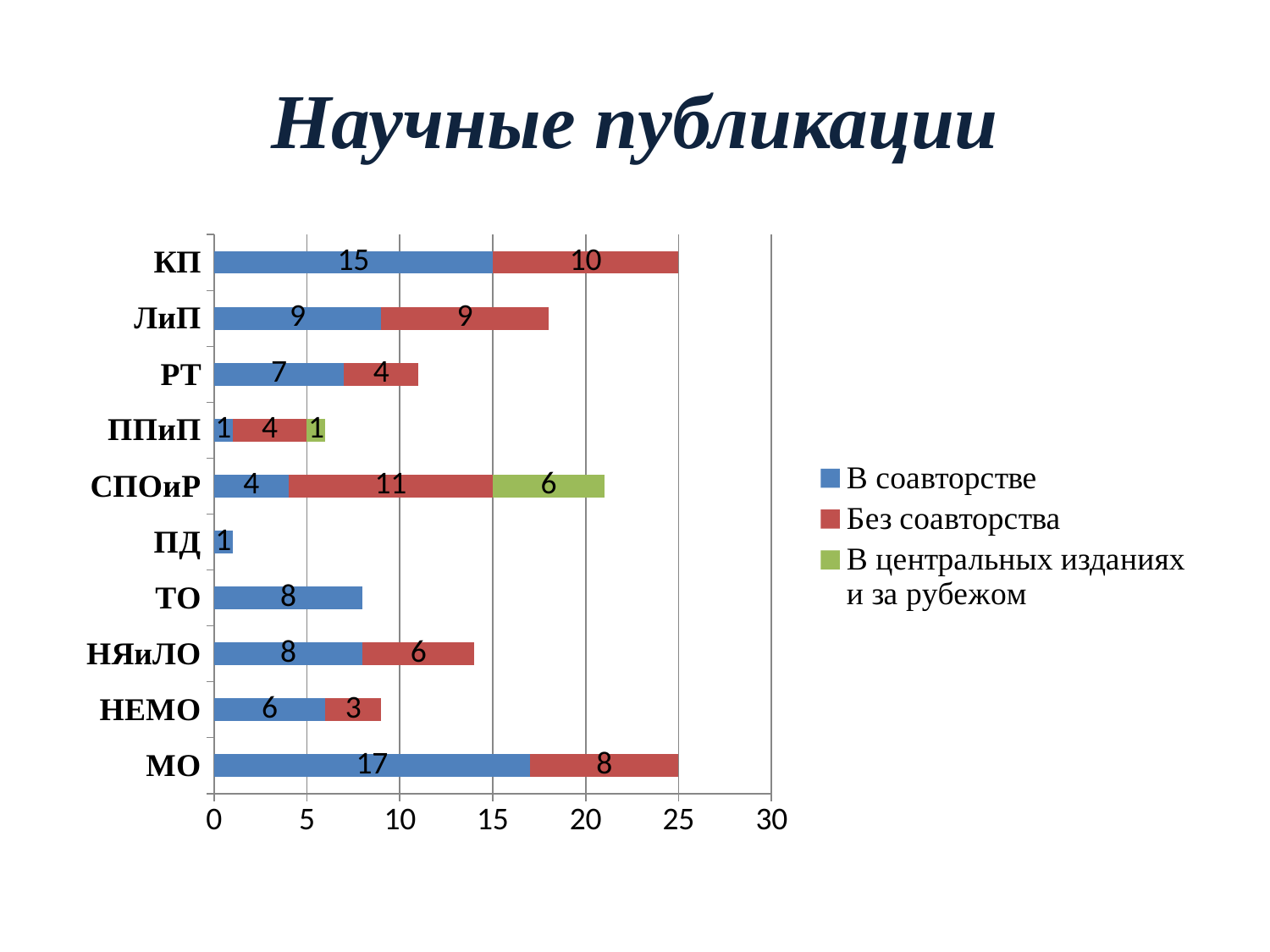
How many series does the legend list? 3 Which is larger: the 'Без соавторства' value for НЯиЛО or for НЕМО? НЯиЛО What kind of chart is shown on the slide? stacked bar chart How many categories are shown on the vertical axis? 10 What is the difference between the 'В соавторстве' values for КП and ЛиП? 6 What is the value of 'Без соавторства' for СПОиР? 11 What is the total of the stacked bar for СПОиР? 21 What is the title of the chart? Научные публикации Which category has the highest value for 'В соавторстве'? МО What is the value of 'В центральных изданиях и за рубежом' for ППиП? 1 Which category has the highest value for 'Без соавторства'? СПОиР What is the value of 'В соавторстве' for МО? 17